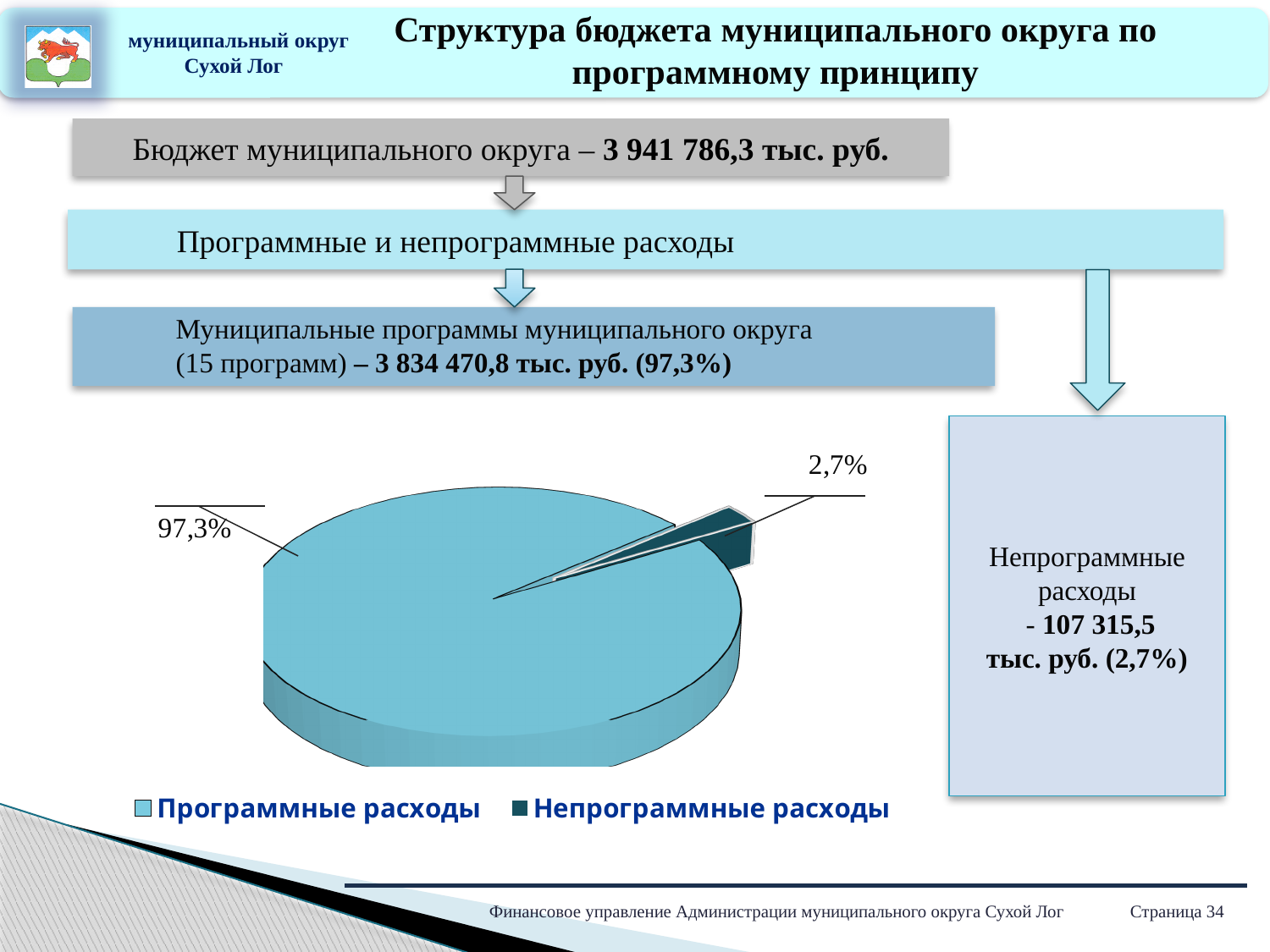
What kind of chart is shown on the slide? pie chart What share of the pie does "Непрограммные расходы" take? 2,7% Which is larger in the pie chart: "Программные расходы" or "Непрограммные расходы"? Программные расходы Which slice of the pie chart is the smallest? Непрограммные расходы How many slices does the pie chart have? 2 What share of the pie does "Программные расходы" take? 97,3% What are the two legend entries of the pie chart? Программные расходы, Непрограммные расходы How many entries does the legend of the pie chart list? 2 Which slice of the pie chart is the largest? Программные расходы What is the difference in percentage points between the "Программные расходы" slice and the "Непрограммные расходы" slice? 94,6 Which legend entry is shown in the dark teal colour in the pie chart? Непрограммные расходы